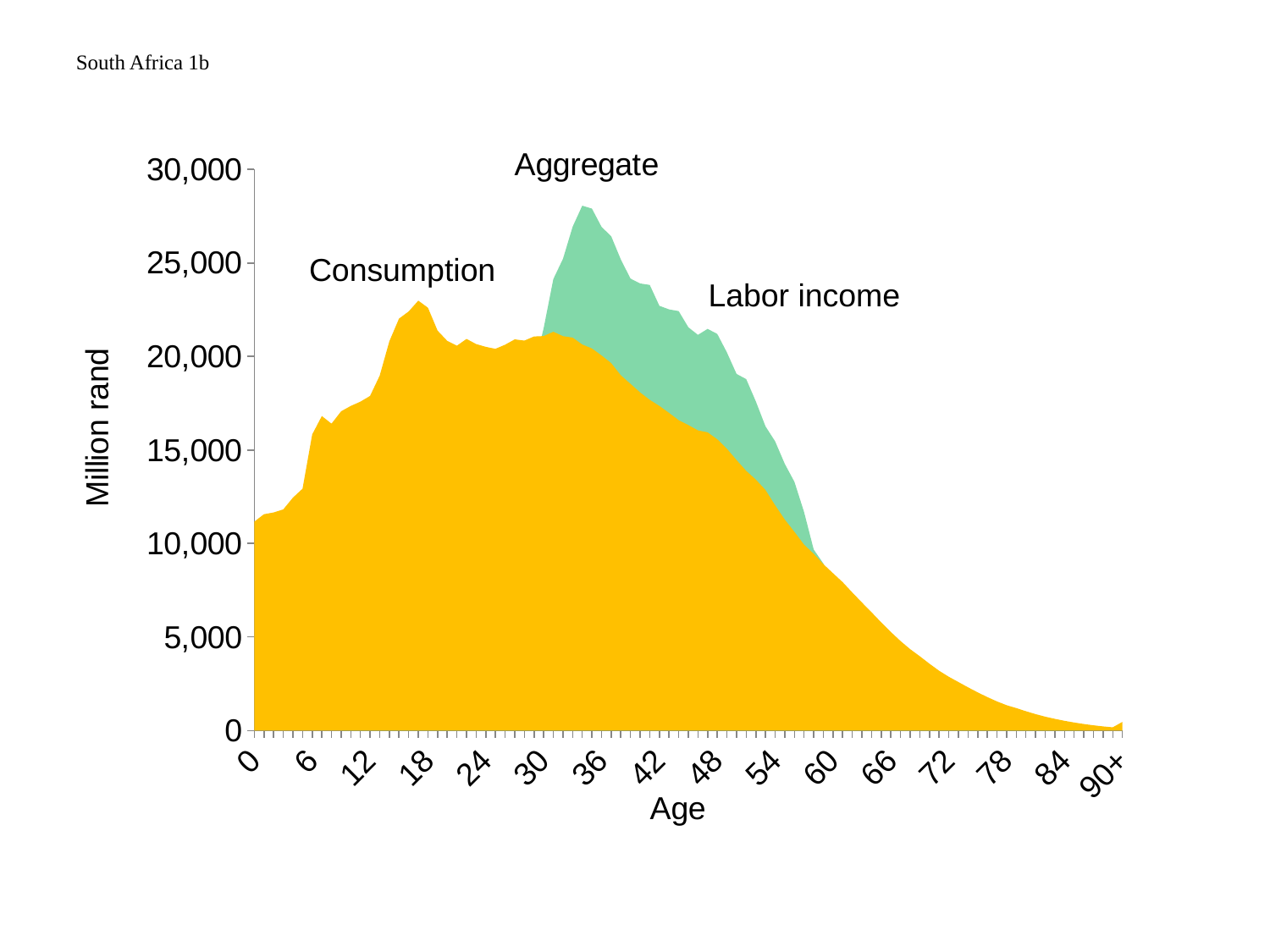
Is the value of Consumption at age 72 greater or less than 5,000? less Is the value of Labor income at age 54 greater or less than 20,000? less Does Consumption rise or fall as age increases from 0 to 18? Rise What is the title of the chart? Aggregate How many data series are plotted in the chart? 2 Is the value of Consumption at age 0 greater or less than 10,000? greater Does Consumption rise or fall as age increases from 60 to 90+? Fall What is the label on the vertical axis of the chart? Million rand At age 42, which is larger, Labor income or Consumption? Labor income What kind of chart is shown on the slide? Area chart